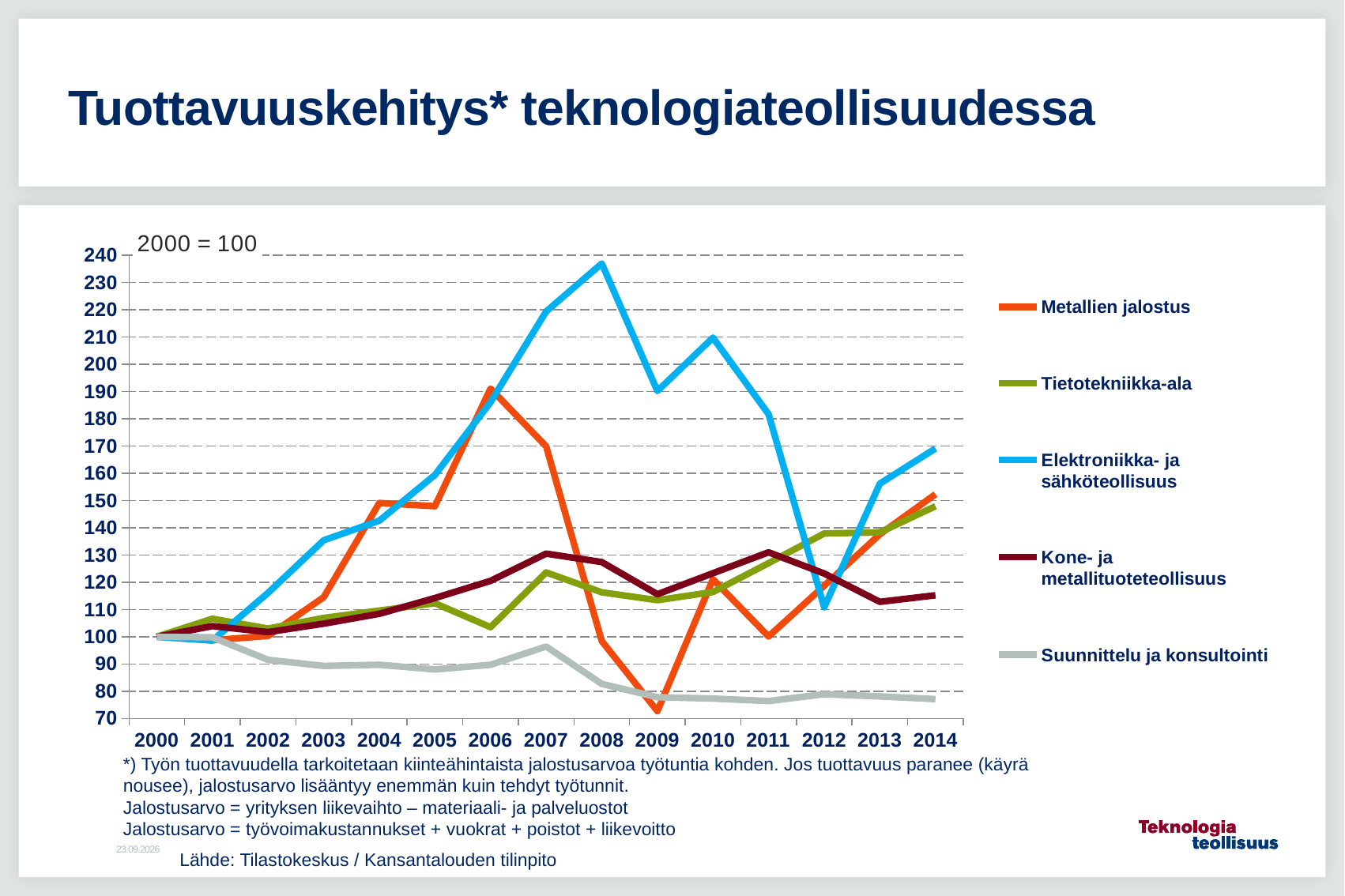
Is the value for Kone- ja metallituoteteollisuus in 2007 greater or less than 120? greater How many series does the legend list? 5 Which series has the lowest value in 2014? Suunnittelu ja konsultointi Is the value for Elektroniikka- ja sähköteollisuus in 2008 greater or less than 230? greater How many years are shown on the x axis? 15 What kind of chart is shown on the slide? line chart Which series reaches the highest value on the chart? Elektroniikka- ja sähköteollisuus In 2012, which is larger: Tietotekniikka-ala or Elektroniikka- ja sähköteollisuus? Tietotekniikka-ala What base year note is printed at the top of the chart? 2000 = 100 Does the Suunnittelu ja konsultointi line rise or fall from 2000 to 2014? fall In which year does the Elektroniikka- ja sähköteollisuus line reach its peak? 2008 Is the value for Metallien jalostus in 2009 greater or less than 80? less